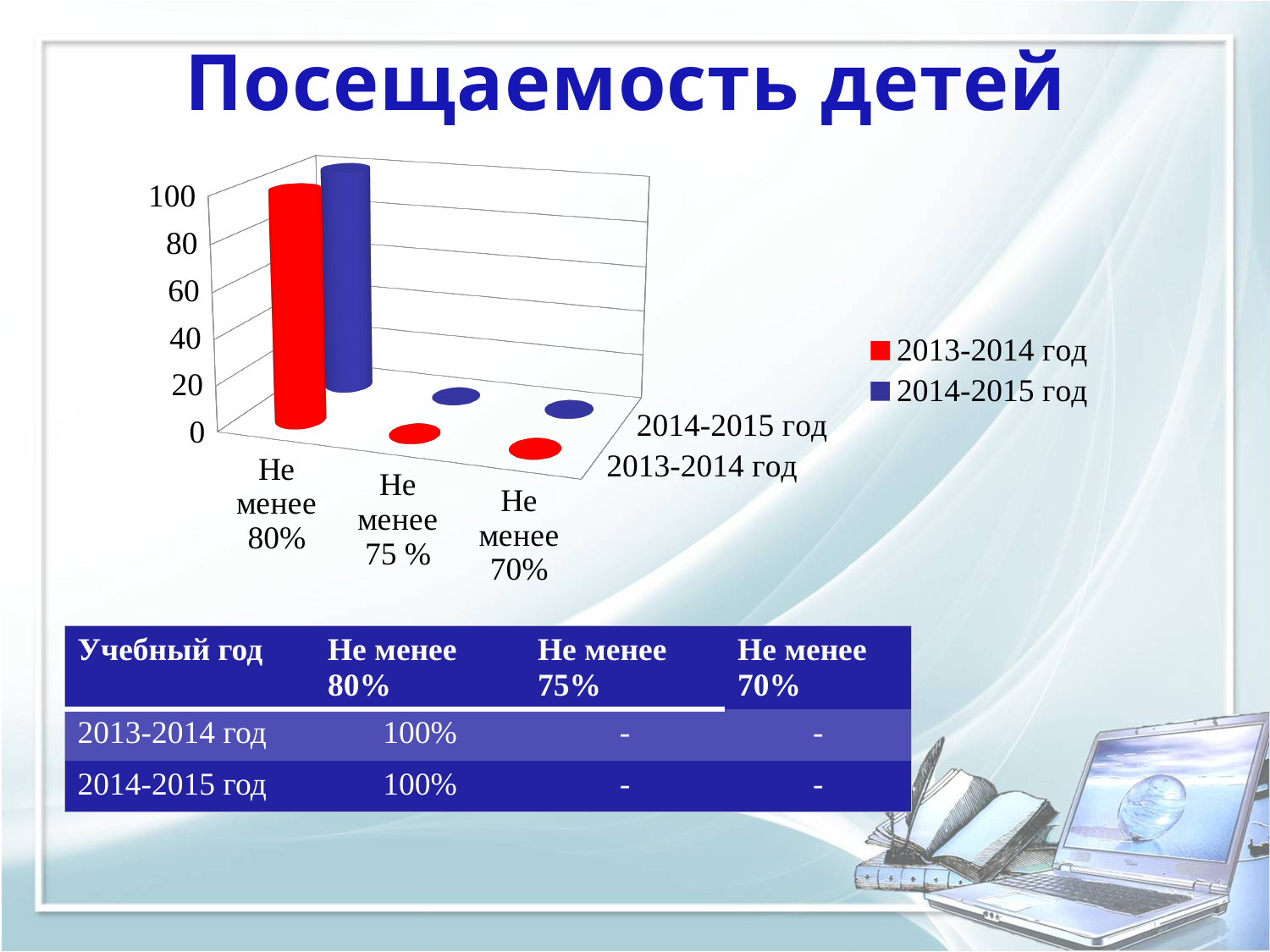
What kind of chart is shown on the slide? bar chart Is the value for Не менее 75 % in the 2014-2015 год series greater or less than 20? less How many categories are shown on the x axis of the chart? 3 Is the value for Не менее 70% in the 2013-2014 год series greater or less than 20? less What is the title of the slide with the chart? Посещаемость детей Which category has the highest value for the 2014-2015 год series? Не менее 80% According to the table below the chart, what is the value for Не менее 80% in 2013-2014 год? 100% Which category has the highest value for the 2013-2014 год series? Не менее 80% Is the value for Не менее 80% in the 2013-2014 год series greater or less than 80? greater Which colour represents the 2014-2015 год series in the chart? blue Which is larger for the 2014-2015 год series: Не менее 80% or Не менее 70%? Не менее 80% How many series does the chart legend list? 2